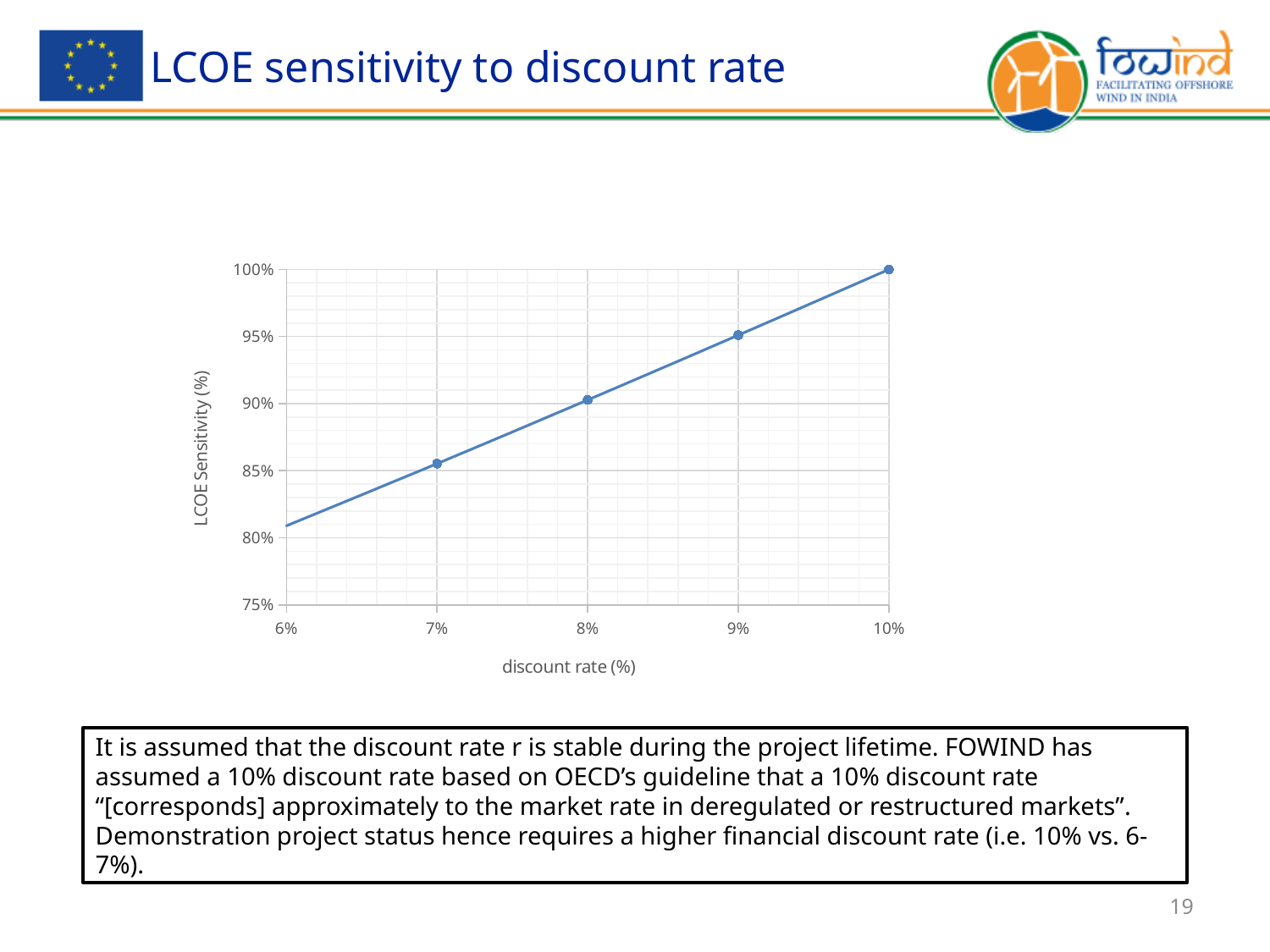
At which discount rate is the LCOE sensitivity highest? 10% At which discount rate is the LCOE sensitivity lowest? 6% How many discount rate values are labelled on the x axis? 5 Is the LCOE sensitivity at a 9% discount rate greater or less than 90%? greater What is the LCOE sensitivity value at a 10% discount rate? 100% What kind of chart is shown on the slide? line chart Is the LCOE sensitivity at a 6% discount rate greater or less than 85%? less Is the LCOE sensitivity at an 8% discount rate greater or less than 85%? greater Does the LCOE sensitivity rise or fall as the discount rate increases from 6% to 10%? rise What is the label of the y axis? LCOE Sensitivity (%) Which has the higher LCOE sensitivity, a 7% discount rate or a 9% discount rate? 9% discount rate